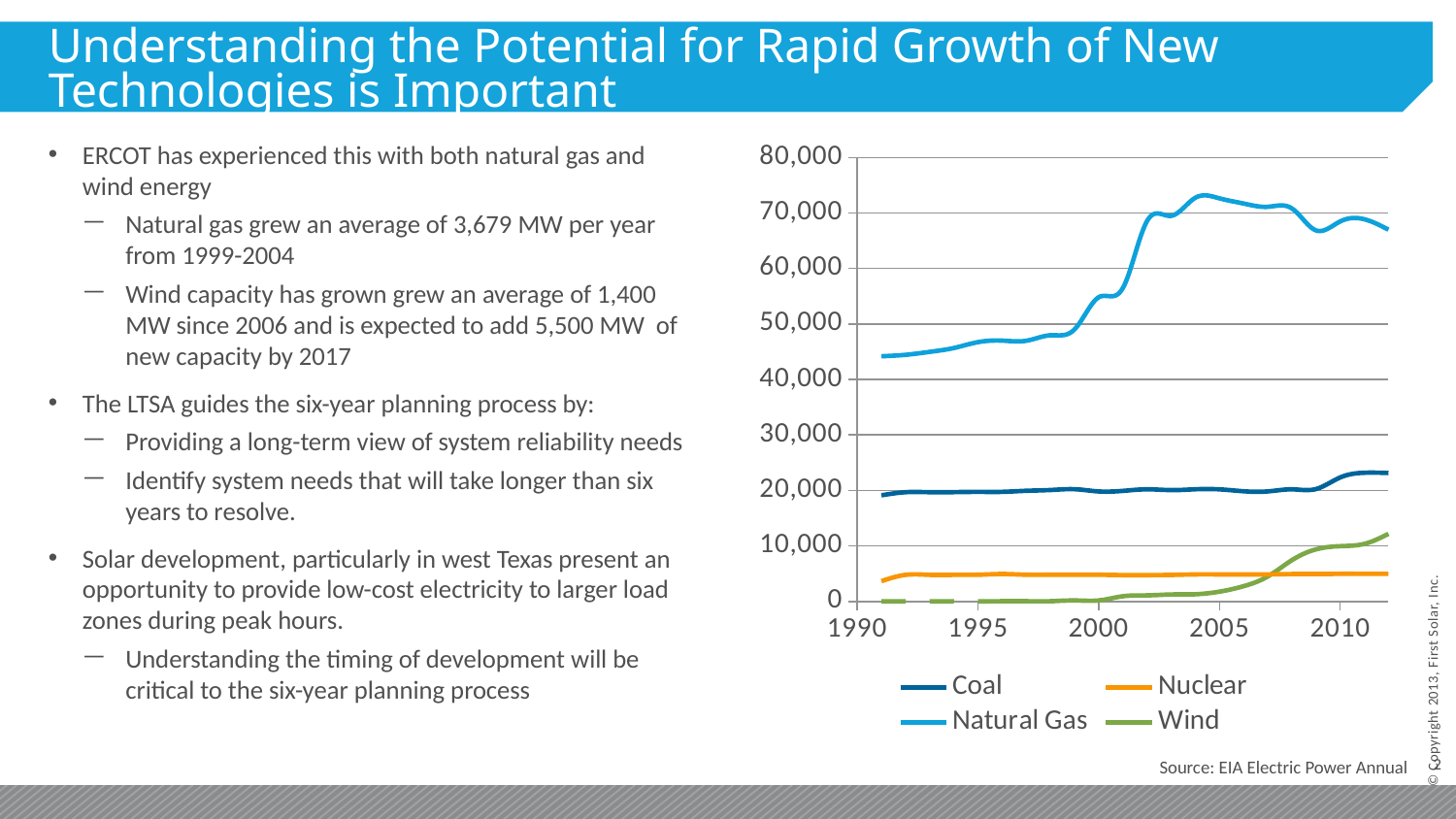
In 2005, which is larger, the value for Coal or the value for Nuclear? Coal How many series does the chart's legend list? 4 Is the value for Natural Gas in 1995 greater or less than 50,000? less Which series has the highest values throughout the chart? Natural Gas Is the value for Wind in 2010 greater or less than 5,000? greater What source is cited below the chart? EIA Electric Power Annual Is the value for Coal in 2000 greater or less than 30,000? less Does the Natural Gas series generally rise or fall from 1990 to 2010? Rise In 2010, which is larger, the value for Wind or the value for Nuclear? Wind Which series has the lowest values in the early 1990s? Wind What kind of chart is shown on the slide? Line chart